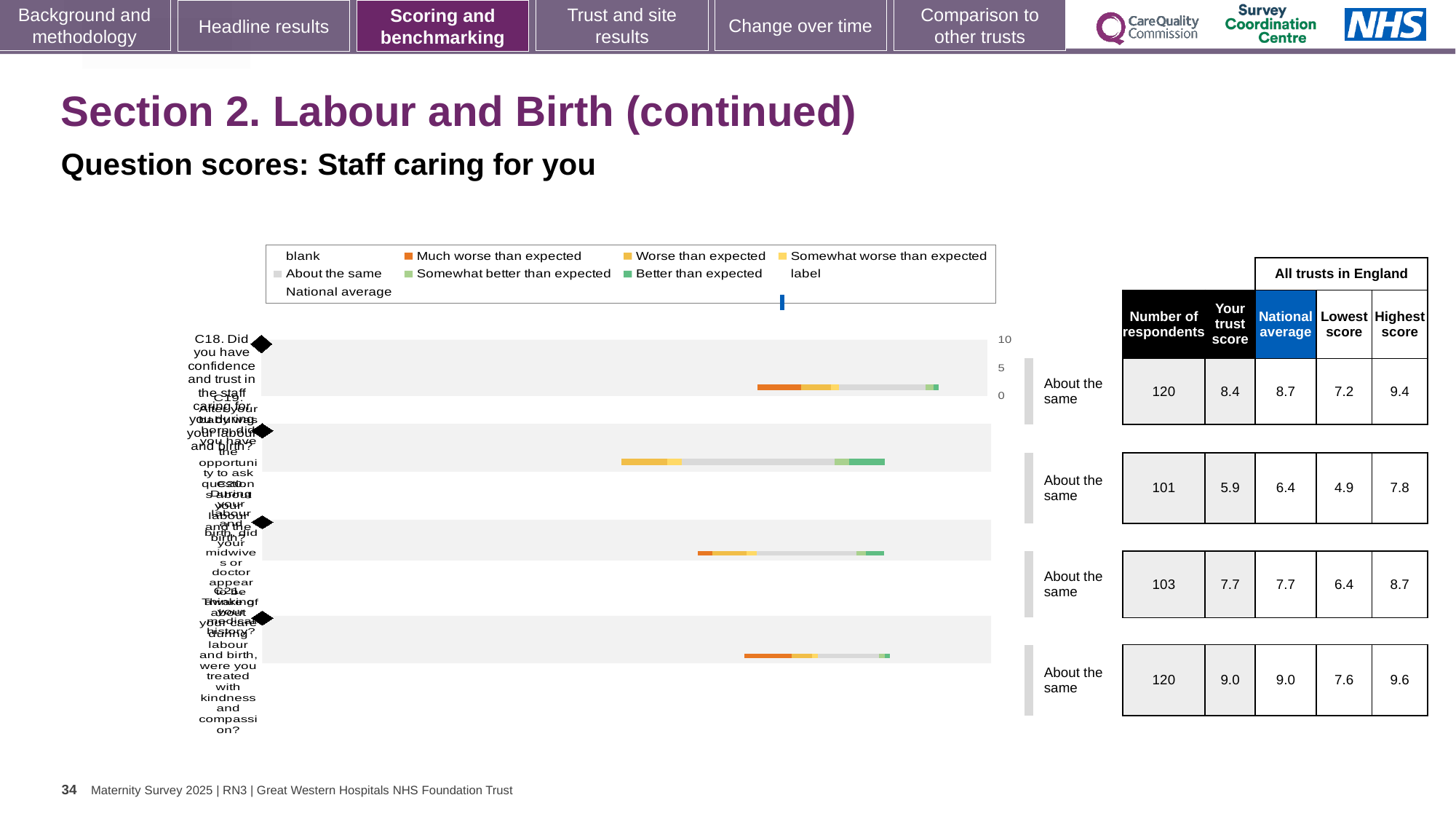
According to the table, how many respondents answered question C20? 103 What kind of chart is shown on the slide? bar chart According to the table, what is the highest score among all trusts in England for question C21? 9.6 How many question rows (bars) does the chart show? 4 Which legend entry is shown in dark orange? Much worse than expected According to the table, what is the trust score for question C18? 8.4 Which question has the lowest trust score in the table? C19 Which question has the highest trust score in the table? C21 For question C19, which is larger: the trust score or the national average? National average What is the difference between the national average and the trust score for question C18? 0.3 What is the highest value shown on the chart's numeric axis? 10 According to the table, what is the national average for question C19? 6.4